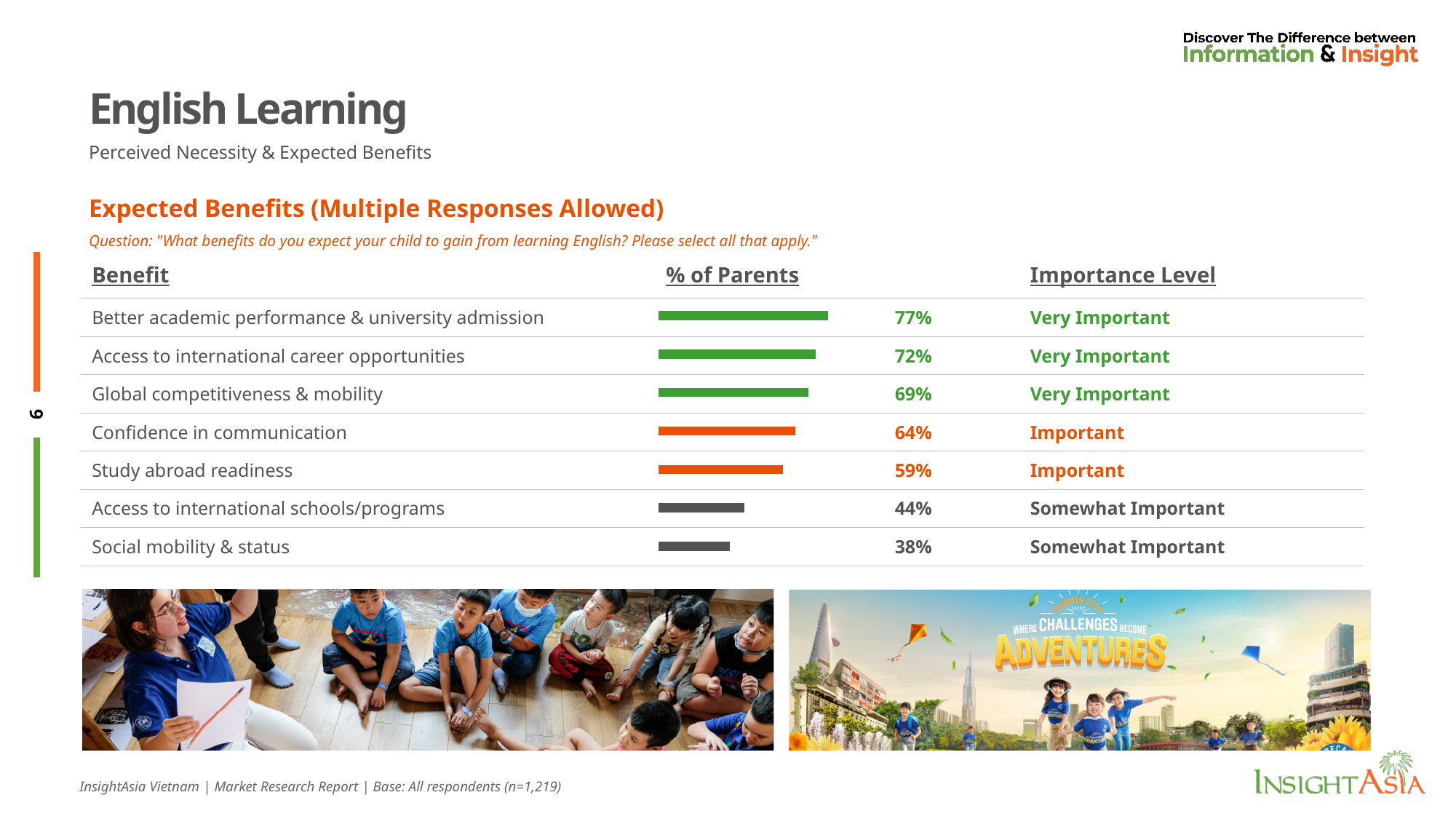
What kind of chart is used to show the % of parents for each benefit? Bar chart What percentage of parents selected social mobility & status? 38% How many benefits are rated as Very Important? 3 Which has a higher percentage of parents: global competitiveness & mobility or study abroad readiness? Global competitiveness & mobility What importance level is assigned to confidence in communication? Important What percentage of parents selected study abroad readiness as an expected benefit? 59% Which expected benefit has the highest percentage of parents? Better academic performance & university admission What is the difference in percentage points between access to international schools/programs and social mobility & status? 6 How many expected benefits are listed in the chart? 7 What is the difference in percentage points between access to international career opportunities and confidence in communication? 8 What percentage of parents expect better academic performance & university admission as a benefit? 77% Which expected benefit has the lowest percentage of parents? Social mobility & status